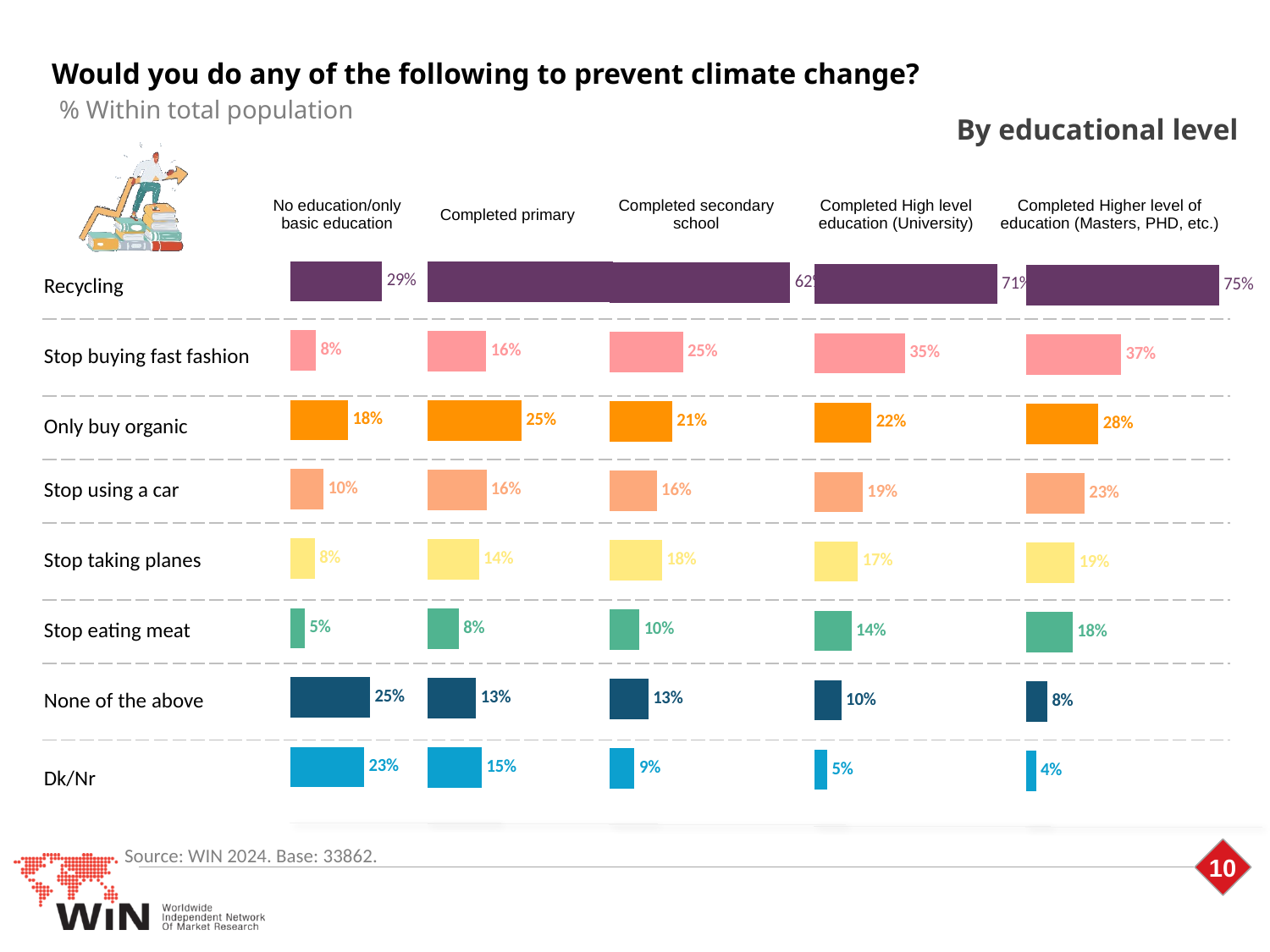
What percentage of respondents with no education/only basic education would stop buying fast fashion? 8% How many response options (rows) are shown in the chart? 8 For 'Only buy organic', which is larger: the value for completed primary or the value for completed secondary school? Completed primary What type of chart is used on this slide? Bar chart How many educational level groups are shown in the chart? 5 What is the difference between the 'Stop buying fast fashion' values for completed higher level of education (Masters, PHD, etc.) and no education/only basic education? 29% Among the educational levels, which has the lowest value for 'Stop using a car'? No education/only basic education Does the 'Stop eating meat' value rise or fall as educational level increases from left to right? Rise What percentage of respondents who completed higher level of education (Masters, PHD, etc.) would recycle? 75% What percentage of respondents who completed primary education answered Dk/Nr? 15% Among the educational levels, which has the highest value for 'None of the above'? No education/only basic education What percentage of respondents who completed high level education (University) would stop eating meat? 14%